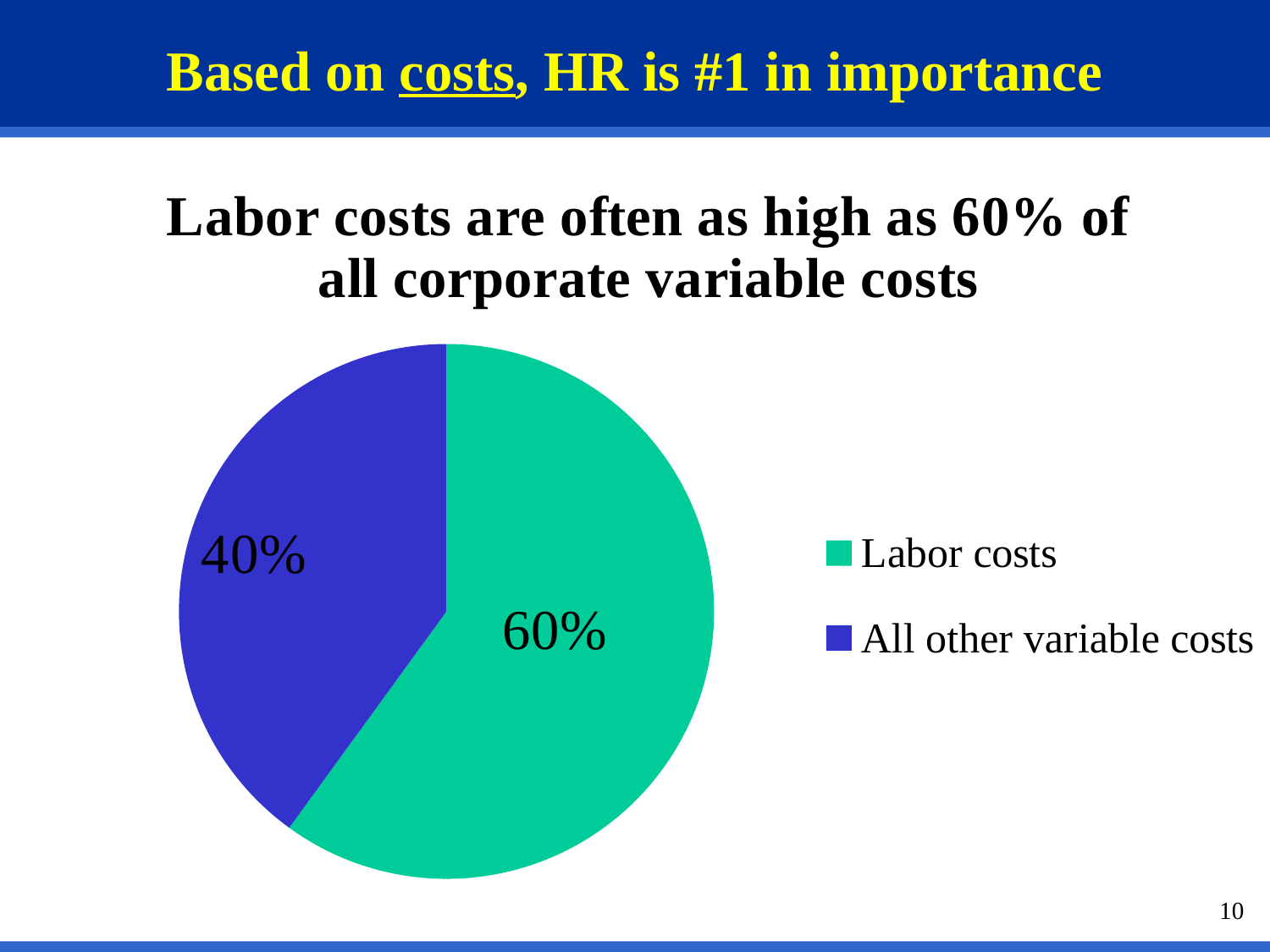
Which is larger, Labor costs or All other variable costs? Labor costs How many slices does the pie chart have? 2 What colour is the Labor costs slice? green Which slice of the pie is the largest? Labor costs What share of the pie is Labor costs? 60% How many entries does the legend list? 2 What colour is the All other variable costs slice? blue What share of the pie is All other variable costs? 40% Which slice of the pie is the smallest? All other variable costs What kind of chart is shown on the slide? pie chart What is the difference between the Labor costs share and the All other variable costs share? 20%